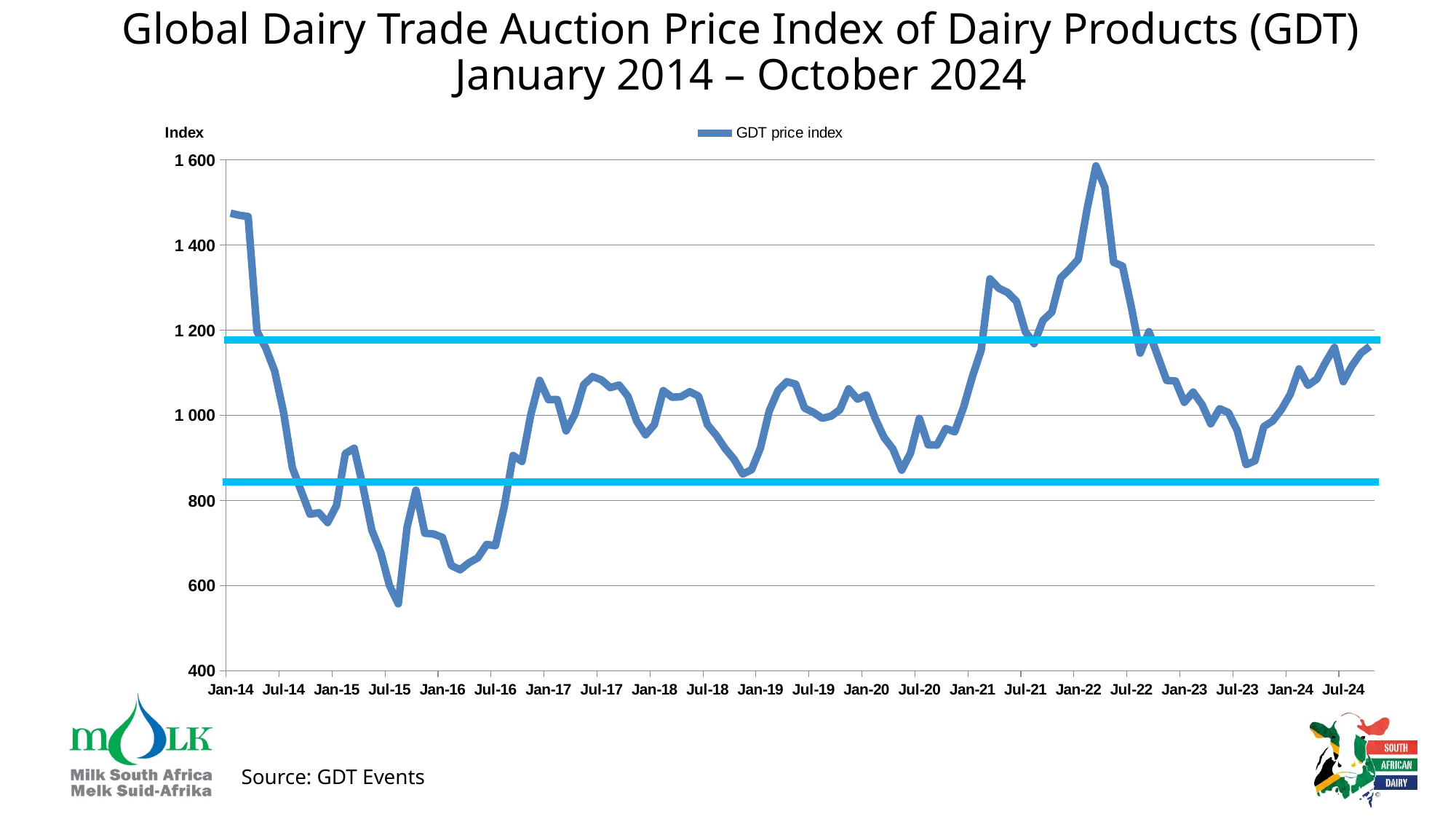
Does the GDT price index rise or fall between Jan-14 and Jul-14? Fall How many series does the legend list? 1 Is the GDT price index value at Jan-14 greater or less than 1 400? greater What is the name of the series shown in the legend? GDT price index Is the GDT price index value at Jan-16 greater or less than 800? less What kind of chart is shown on the slide? Line chart What is the label on the vertical axis? Index Is the highest point of the GDT price index greater or less than 1 500? greater In which period does the GDT price index reach its highest value? Early 2022 (between Jan-22 and Jul-22)